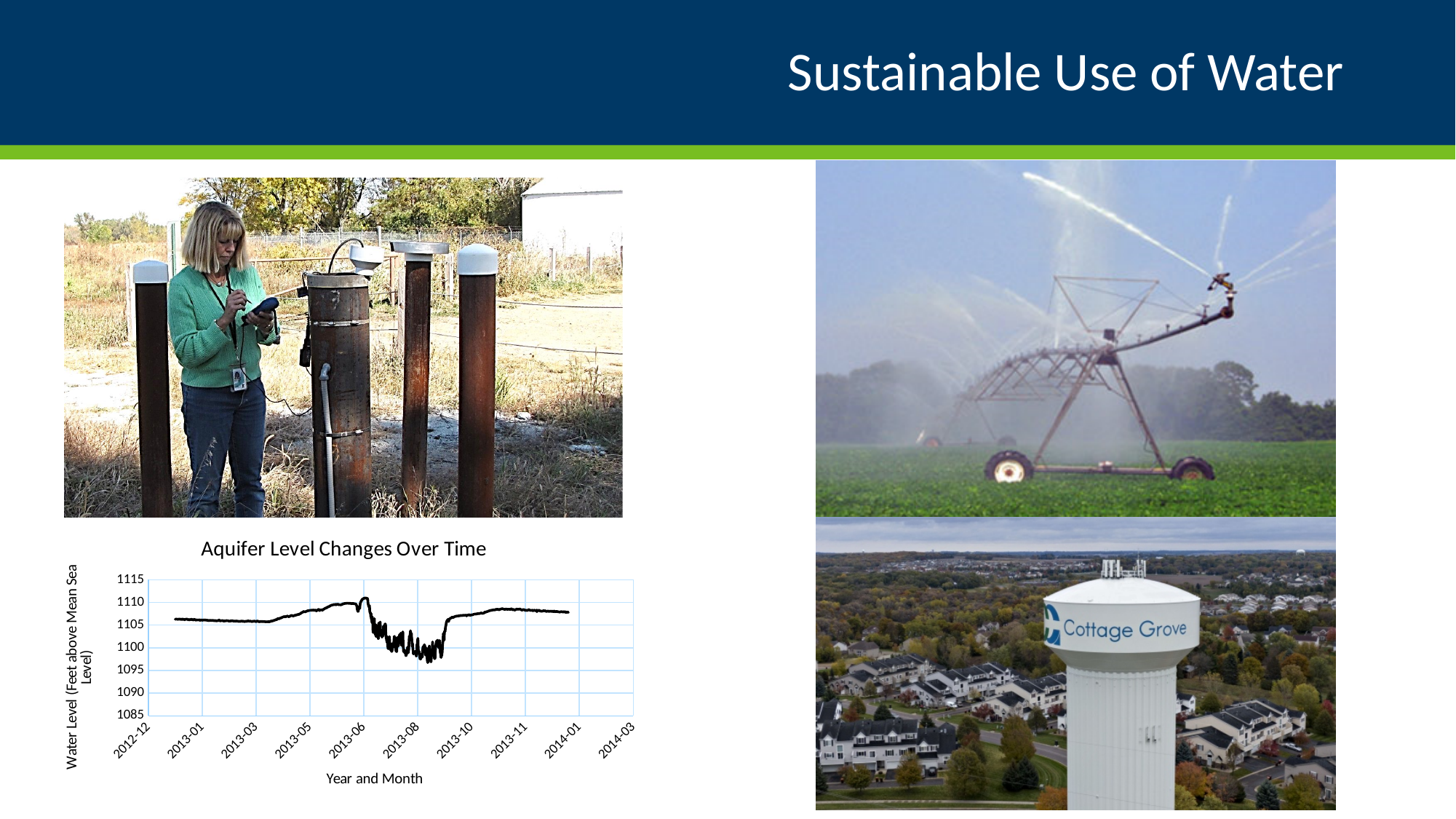
In the "Aquifer Level Changes Over Time" chart, is the water level at 2013-08 greater or less than 1105? less What is the highest value shown on the y-axis of the "Aquifer Level Changes Over Time" chart? 1115 In the "Aquifer Level Changes Over Time" chart, is the water level higher at 2013-05 or at 2013-08? 2013-05 In the "Aquifer Level Changes Over Time" chart, does the water level ever fall below 1090? No In the "Aquifer Level Changes Over Time" chart, does the water level rise or fall between 2013-06 and 2013-08? fall What kind of chart is "Aquifer Level Changes Over Time"? line chart What is the title of the chart on the slide? Aquifer Level Changes Over Time In the "Aquifer Level Changes Over Time" chart, is the water level at 2013-05 greater or less than 1105? greater In the "Aquifer Level Changes Over Time" chart, between which two x-axis ticks does the lowest water level occur? 2013-08 and 2013-10 What is the x-axis label of the "Aquifer Level Changes Over Time" chart? Year and Month In the "Aquifer Level Changes Over Time" chart, does the water level rise or fall between 2013-03 and 2013-06? rise